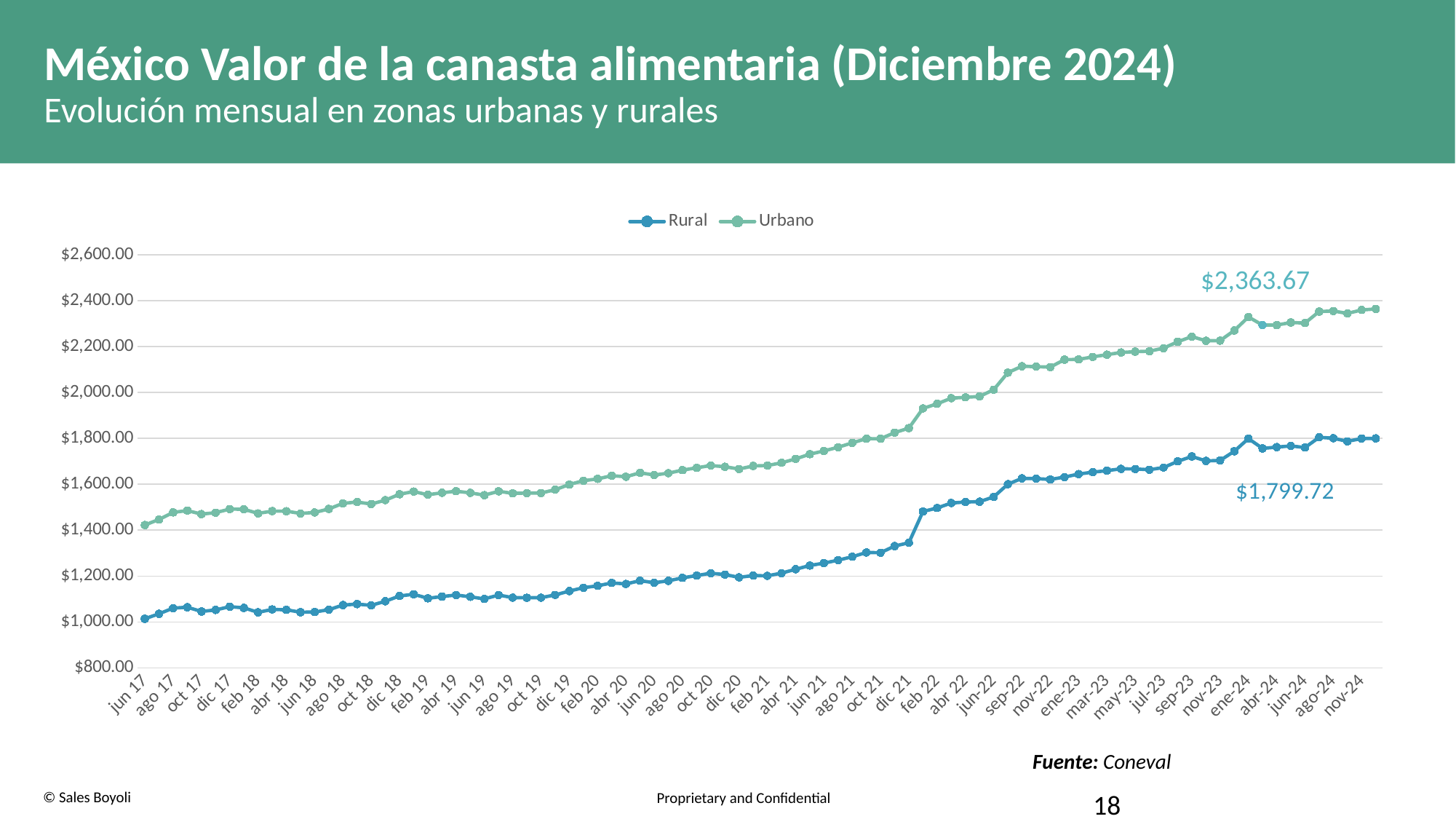
What type of chart is shown on the slide? Line chart What is the difference between the labelled final values of the Urbano and Rural series? $563.95 Which series is consistently higher across the whole period, Rural or Urbano? Urbano Is the value for Urbano in jun 17 greater or less than $1,600.00? less Do the values of the Rural series generally rise or fall from jun 17 to nov-24? Rise What are the names of the two series in the legend? Rural and Urbano Is the value for Rural in jun 17 greater or less than $1,200.00? less What is the labelled value of the Urbano series at the end of the chart (nov-24)? $2,363.67 Which series has the higher value at the end of the chart, Rural or Urbano? Urbano How many series does the legend list? 2 Is the value for Rural in feb 22 greater or less than $1,600.00? less What is the labelled value of the Rural series at the end of the chart (nov-24)? $1,799.72